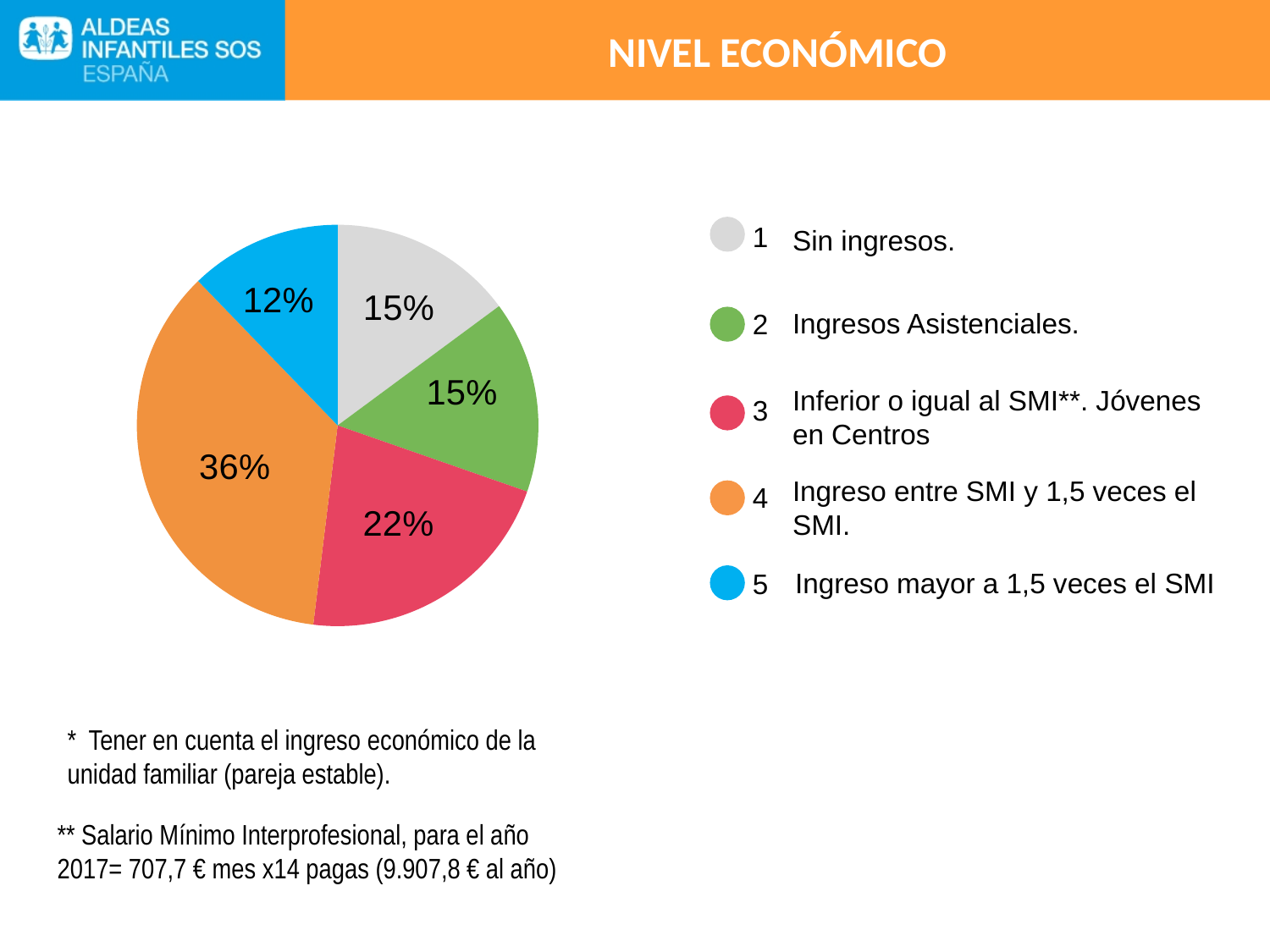
How many categories does the pie chart have? 5 Which category has the largest slice of the pie? Ingreso entre SMI y 1,5 veces el SMI What colour is the slice for "Ingreso mayor a 1,5 veces el SMI"? blue What is the difference in percentage points between the slice for "Ingreso entre SMI y 1,5 veces el SMI" and the slice for "Inferior o igual al SMI. Jóvenes en Centros"? 14 What share of the pie does "Ingresos Asistenciales" represent? 15% What share of the pie does "Ingreso mayor a 1,5 veces el SMI" represent? 12% What kind of chart is shown on the slide? pie chart What share of the pie does "Ingreso entre SMI y 1,5 veces el SMI" represent? 36% Which category has the smallest slice of the pie? Ingreso mayor a 1,5 veces el SMI Which is larger: the slice for "Inferior o igual al SMI. Jóvenes en Centros" or the slice for "Ingreso mayor a 1,5 veces el SMI"? Inferior o igual al SMI. Jóvenes en Centros